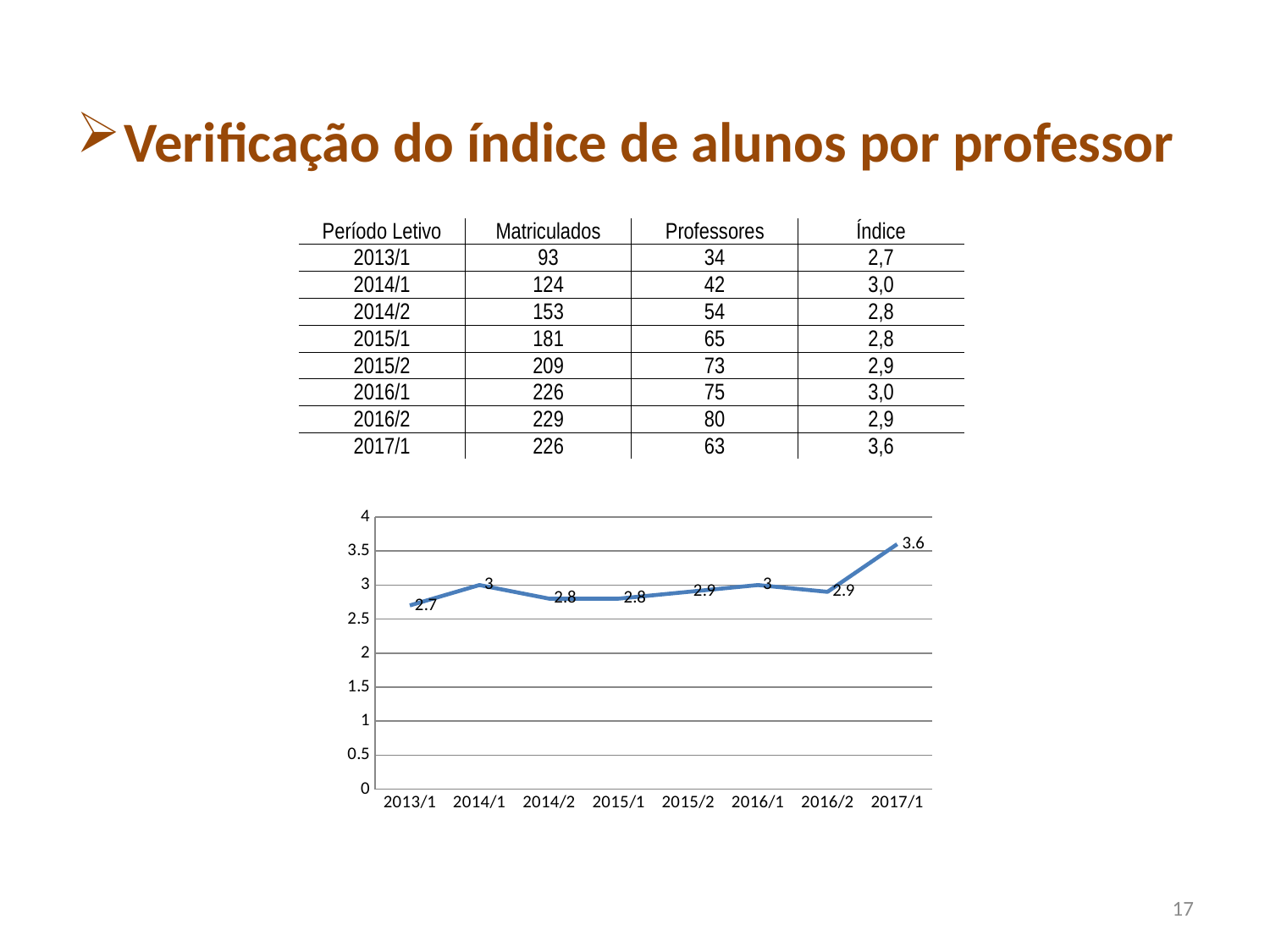
What is the difference between the values for 2017/1 and 2013/1 in the chart? 0.9 How many periods are plotted along the x axis of the chart? 8 Which period has the highest value in the chart? 2017/1 What is the value plotted for 2017/1 in the chart? 3.6 Which period has the lowest value in the chart? 2013/1 What is the value plotted for 2013/1 in the chart? 2.7 What type of chart is shown on the slide? line chart Which is larger in the chart, the value for 2014/1 or the value for 2014/2? 2014/1 What is the highest value shown on the chart's vertical axis? 4 What is the difference between the values for 2017/1 and 2016/2 in the chart? 0.7 What is the value plotted for 2015/2 in the chart? 2.9 Is the value for 2017/1 in the chart greater or less than 3.5? greater